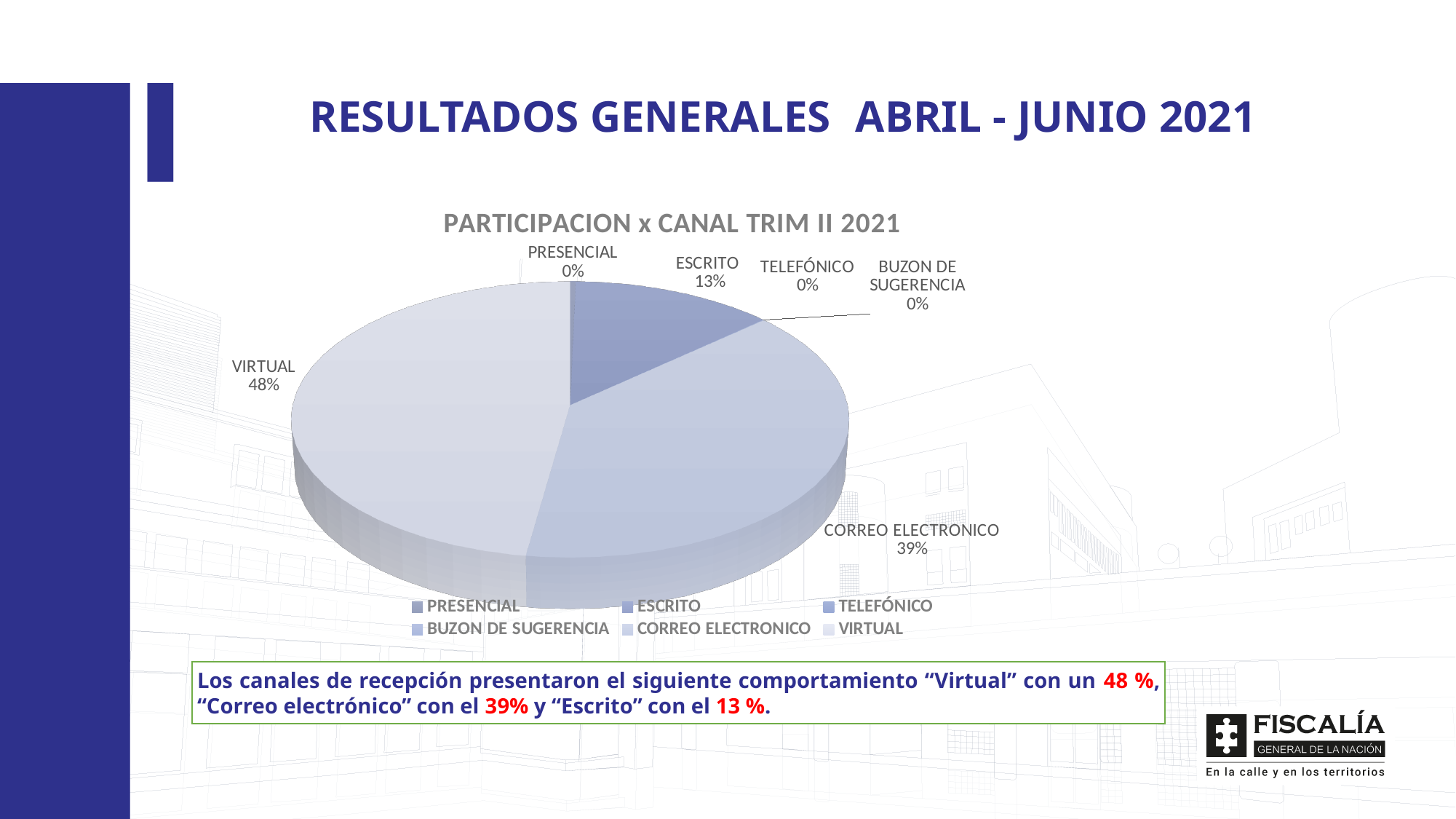
What share of the pie does ESCRITO have? 13% Which is larger, the share for CORREO ELECTRONICO or the share for ESCRITO? CORREO ELECTRONICO What share of the pie does CORREO ELECTRONICO have? 39% What kind of chart is shown on the slide? Pie chart What is the combined share of VIRTUAL and CORREO ELECTRONICO? 87% What share of the pie does TELEFÓNICO have? 0% What is the chart's title? PARTICIPACION x CANAL TRIM II 2021 How many categories does the legend list? 6 Which category has the largest share of the pie? VIRTUAL How many categories are labelled with 0% on the chart? 3 What is the difference between the VIRTUAL share and the CORREO ELECTRONICO share? 9%